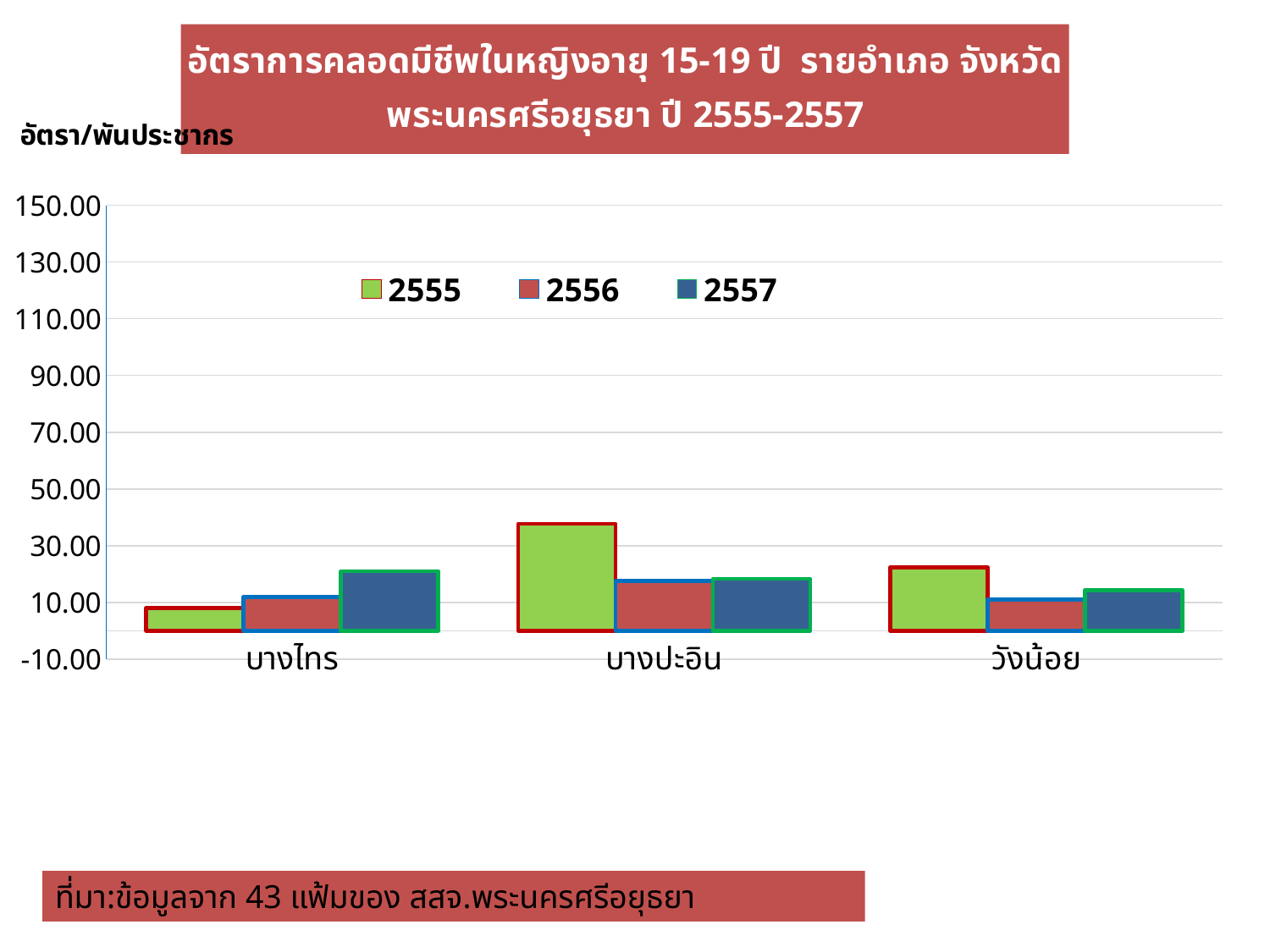
For บางไทร, which is larger: the 2555 value or the 2557 value? 2557 Is the 2556 value for บางปะอิน greater or less than 30? less Which series is shown in green in the legend? 2555 For บางปะอิน, which is larger: the 2555 value or the 2556 value? 2555 Is the 2555 value for บางไทร greater or less than 10? less Is the 2555 value for บางปะอิน greater or less than 30? greater Which district has the highest value for the 2555 series? บางปะอิน Which district has the lowest value for the 2555 series? บางไทร How many districts (categories) are shown on the x axis? 3 How many series does the legend list? 3 What kind of chart is shown on the slide? bar chart